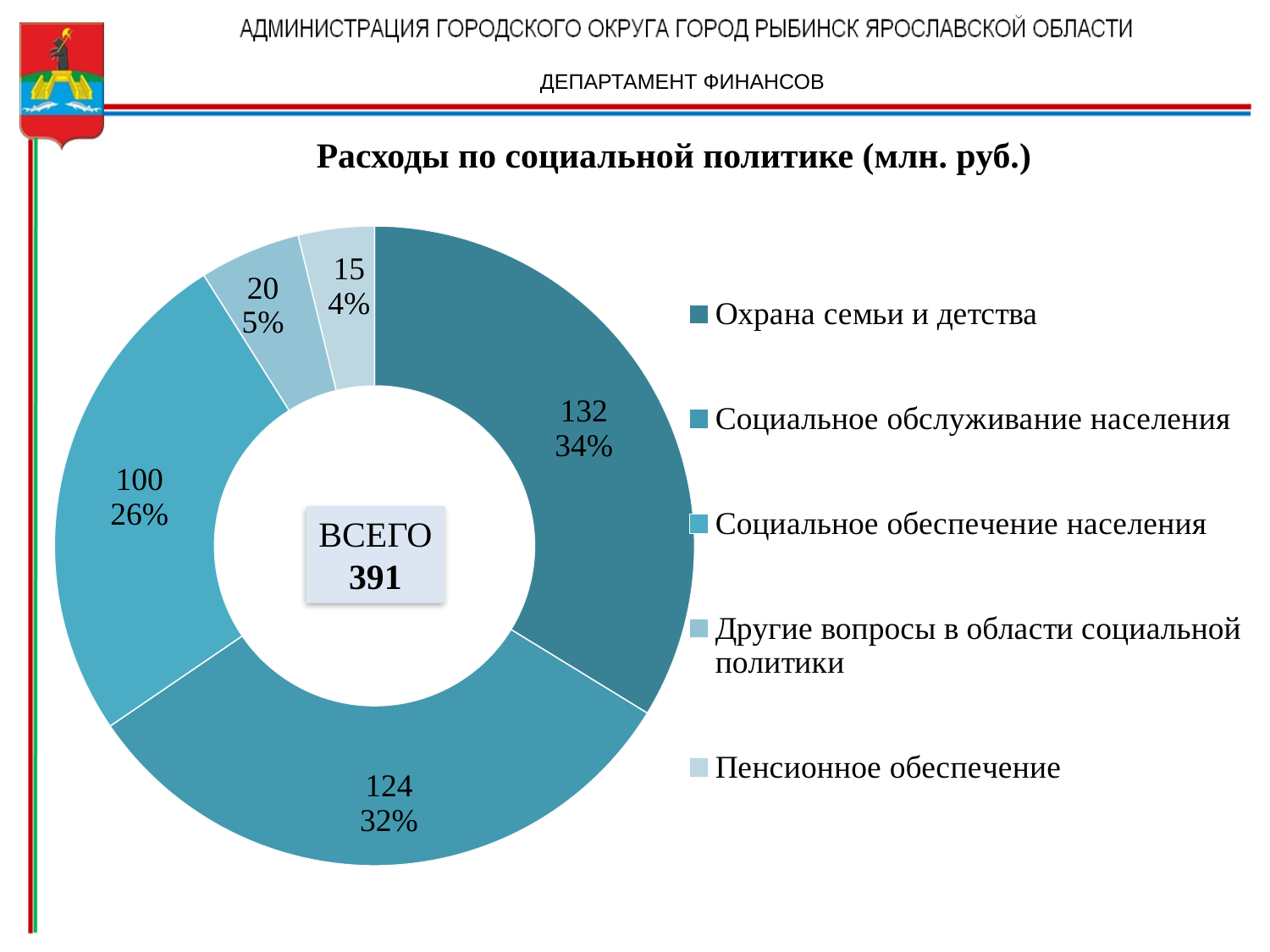
Which is larger, the value for Социальное обеспечение населения or the value for Социальное обслуживание населения? Социальное обслуживание населения How many categories are shown in the chart? 5 What is the value for Социальное обслуживание населения? 124 What is the value for Охрана семьи и детства? 132 What share of the chart does Социальное обеспечение населения represent? 26% Which category has the lowest value? Пенсионное обеспечение What total value is shown in the centre of the chart? 391 What is the difference between the values for Охрана семьи и детства and Социальное обслуживание населения? 8 What is the value for Пенсионное обеспечение? 15 Which category has the highest value? Охрана семьи и детства What share of the chart does Другие вопросы в области социальной политики represent? 5% What type of chart is shown on the slide? Doughnut chart